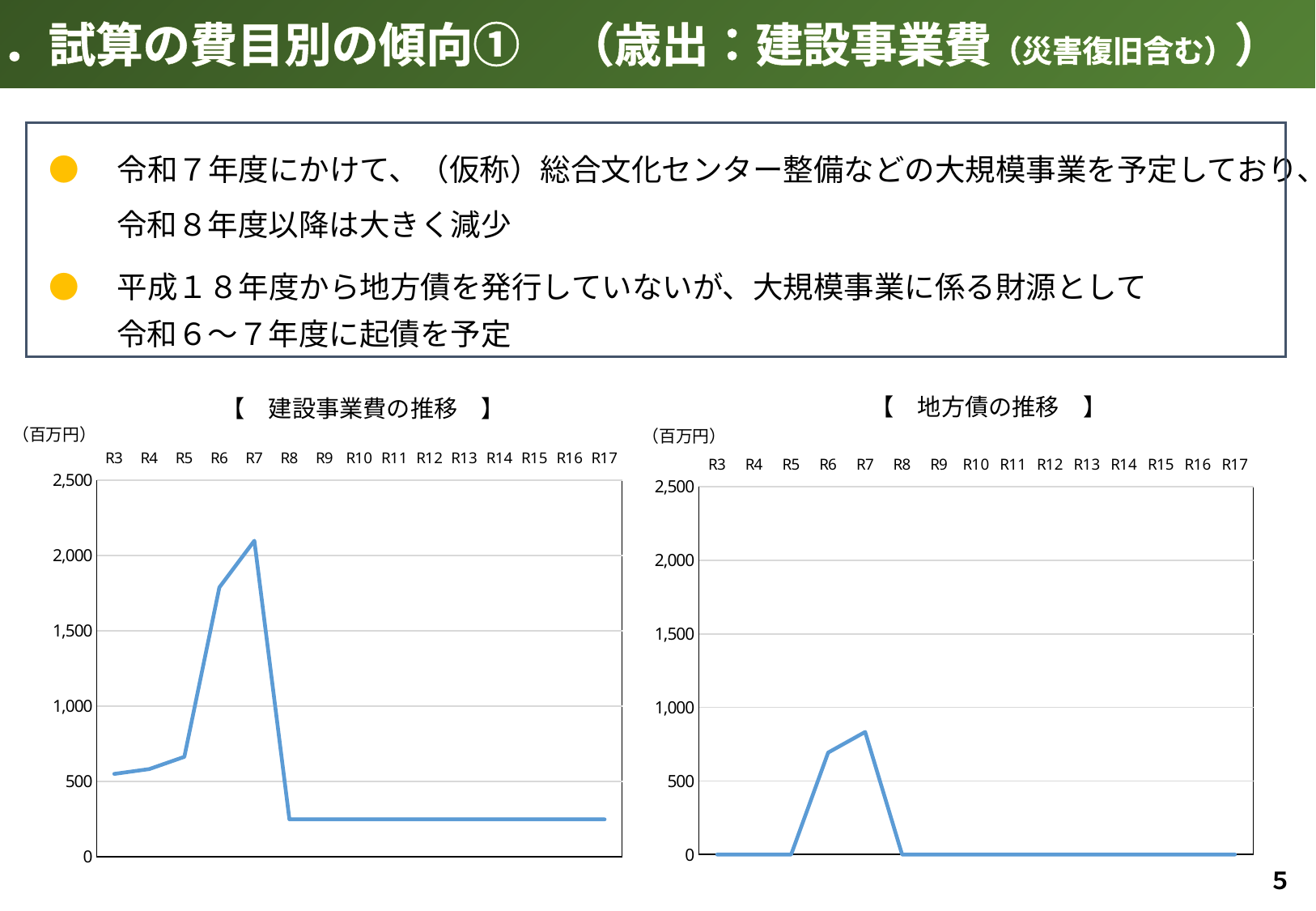
In the 地方債の推移 chart on the right, does the value rise or fall from R5 to R7? rise In the 地方債の推移 chart on the right, which year has the highest value? R7 In the 地方債の推移 chart on the right, is the value for R7 greater or less than 1,000? less In the 建設事業費の推移 chart on the left, does the value rise or fall from R7 to R8? fall In the 建設事業費の推移 chart on the left, is the value for R7 greater or less than 2,000? greater What unit is shown above the y axis of the 建設事業費の推移 chart on the left? 百万円 In the 地方債の推移 chart on the right, what is the value for R3? 0 In the 建設事業費の推移 chart on the left, is the value for R8 greater or less than 500? less In the 建設事業費の推移 chart on the left, which year has the highest value? R7 What kind of chart is the 建設事業費の推移 chart on the left? line chart How many years are plotted on the x axis of the 地方債の推移 chart on the right? 15